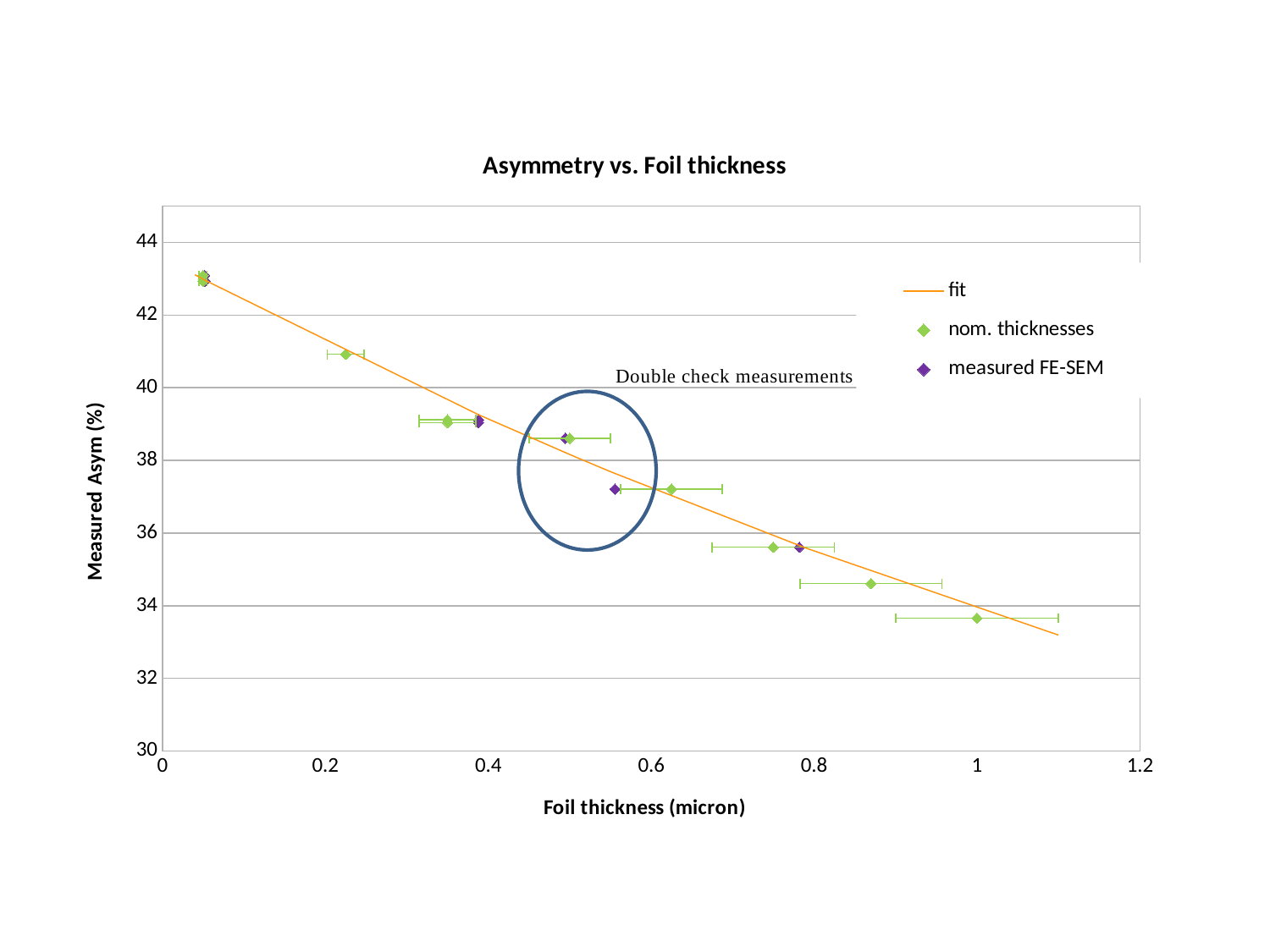
Is the measured asymmetry for the leftmost data point (near 0.05 micron) greater or less than 42? greater Is the measured asymmetry for the nom. thicknesses point near 0.22 micron greater or less than 40? greater How many series does the legend list? 3 Which series is drawn as an orange line? fit Which nom. thicknesses point has the lowest measured asymmetry: the one at 1 micron or the one near 0.22 micron? the one at 1 micron Is the measured asymmetry for the nom. thicknesses point near 0.75 micron greater or less than 36? less What is the title of the chart? Asymmetry vs. Foil thickness What kind of chart is shown on the slide? scatter plot What is the label of the y axis? Measured Asym (%) Does the measured asymmetry rise or fall as foil thickness increases? fall